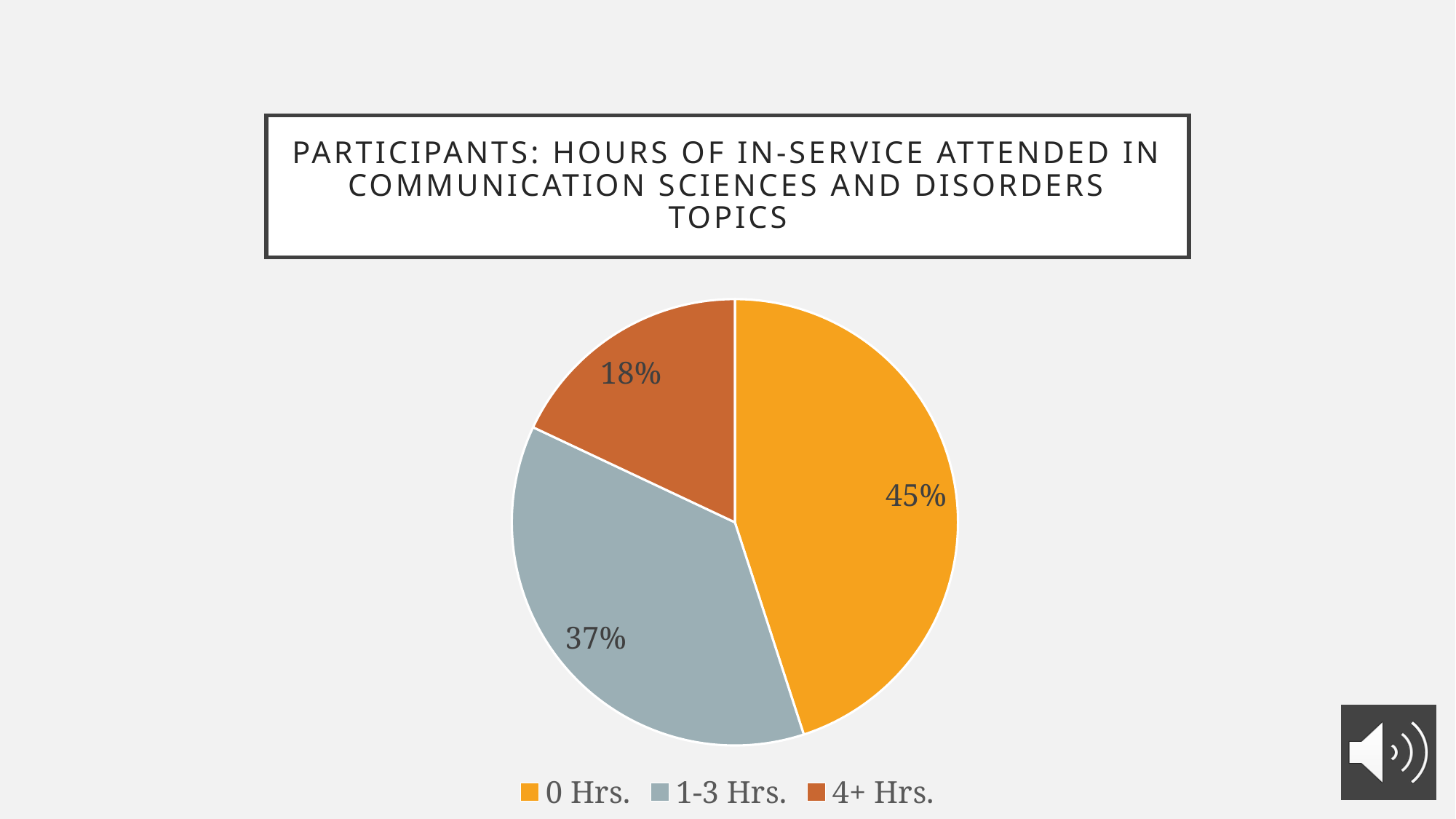
What kind of chart is shown on the slide? pie chart What is the title of the chart? Participants: Hours of In-Service Attended in Communication Sciences and Disorders Topics What is the difference in percentage points between the 0 Hrs. and 1-3 Hrs. slices? 8 What colour is the slice for 4+ Hrs.? dark orange (brown-orange) Which category has the smallest share of the pie? 4+ Hrs. Which is larger, the share for 1-3 Hrs. or the share for 4+ Hrs.? 1-3 Hrs. How many categories does the pie chart show? 3 What percentage of participants attended 1-3 Hrs. of in-service? 37% Which category has the largest share of the pie? 0 Hrs. What is the difference in percentage points between the 0 Hrs. and 4+ Hrs. slices? 27 What percentage of participants attended 4+ Hrs. of in-service? 18% What percentage of participants attended 0 Hrs. of in-service? 45%